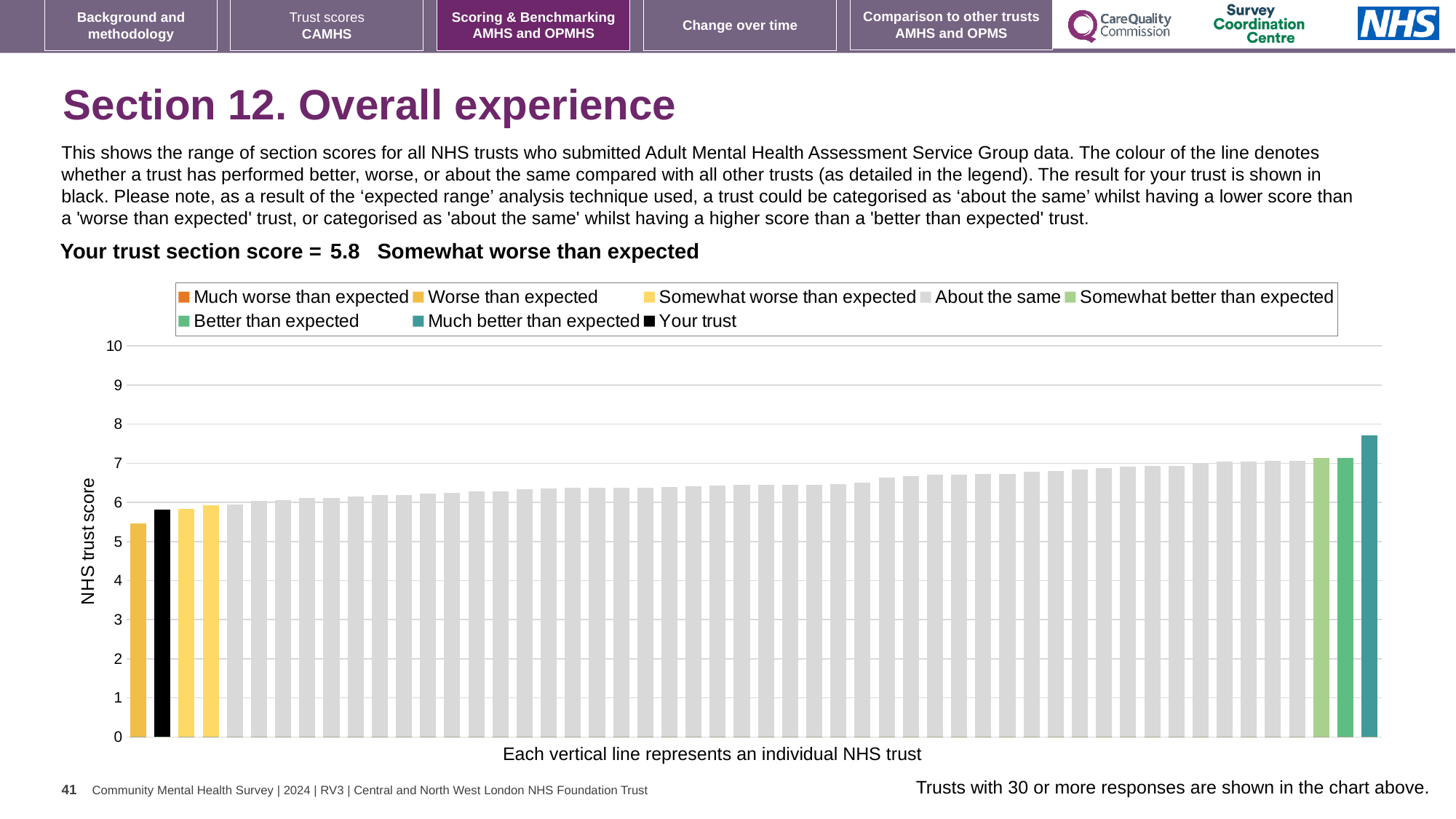
Is the value for your trust (the black bar) greater or less than 6? less Which is larger: the value for your trust (black bar) or the value for the leftmost bar? Your trust Is the value for the tallest bar greater or less than 7? greater What is the section score for your trust (the black bar)? 5.8 How many entries does the chart legend list? 8 What is the label on the vertical axis? NHS trust score Which legend category does the tallest bar belong to? Much better than expected What kind of chart is shown on the slide? bar chart Which legend category is your trust's score classified as? Somewhat worse than expected Is the value for the leftmost bar greater or less than 5? greater Do the bar values rise or fall from left to right along the x axis? rise How many bars are coloured as 'Much better than expected'? 1